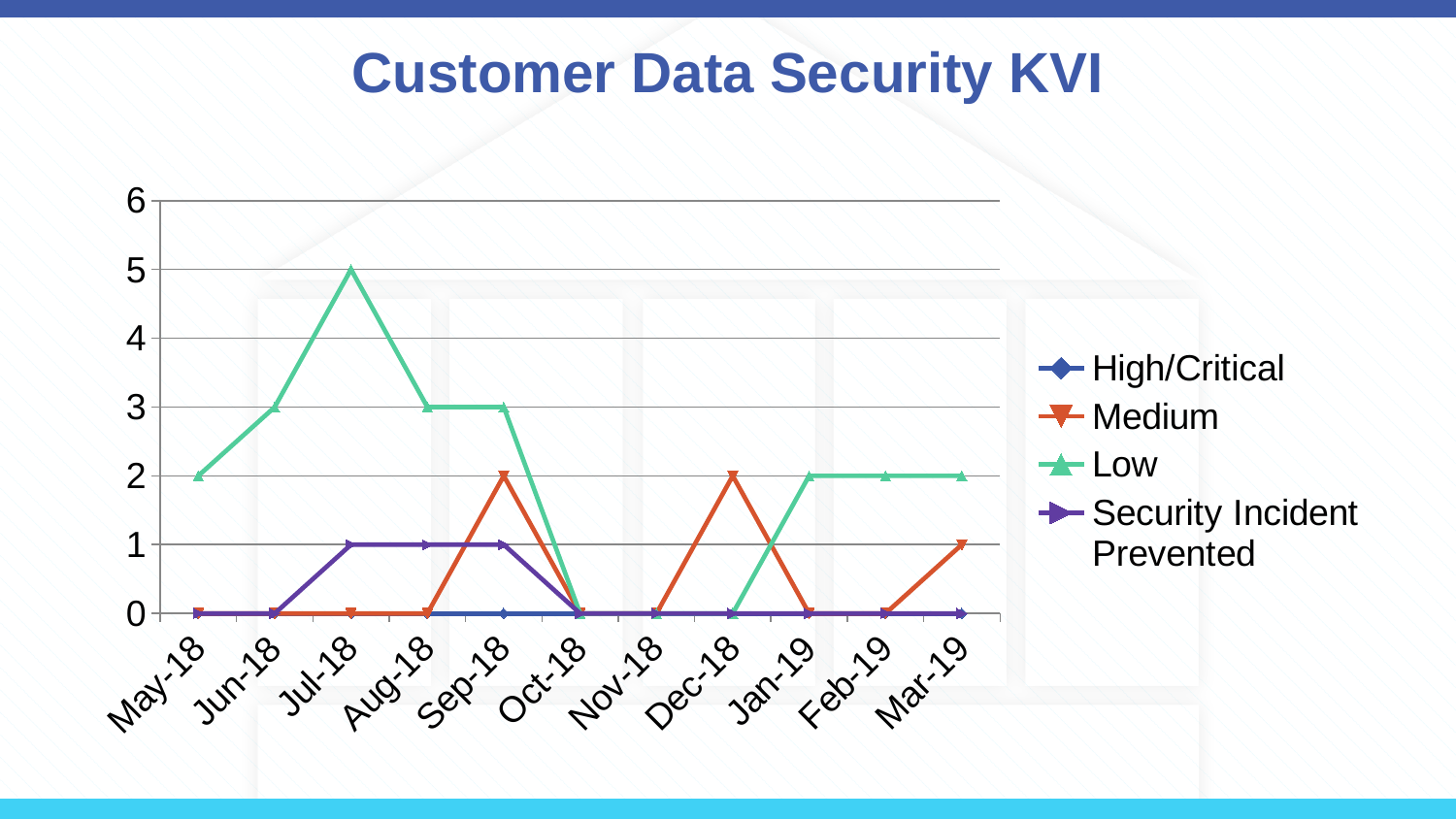
How many series does the legend list? 4 Which is larger in Dec-18, the Medium value or the Low value? Medium In which month does the Low series reach its highest value? Jul-18 Does the Low series rise or fall from May-18 to Jul-18? rise What kind of chart is shown on the slide? line chart What is the value of the Medium series in Mar-19? 1 How many months are shown on the x axis? 11 What is the title of the chart? Customer Data Security KVI What is the difference between the Low value in Jul-18 and the Low value in Aug-18? 2 What is the value of the Security Incident Prevented series in Aug-18? 1 What is the value of the Low series in Jul-18? 5 What is the value of the Medium series in Sep-18? 2